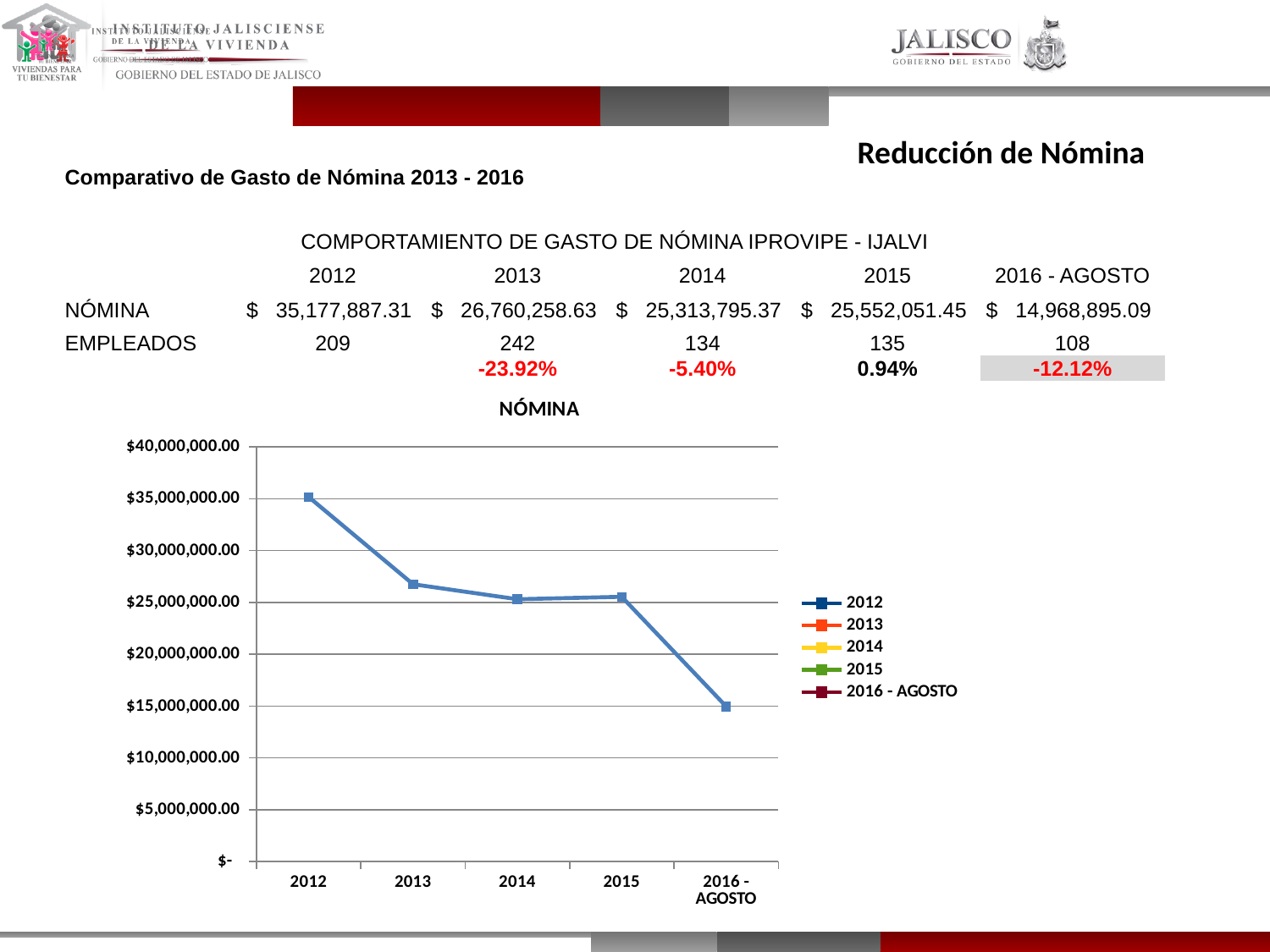
How many entries does the legend of the NÓMINA chart list? 5 What is the difference between the nómina values for 2012 and 2013? $ 8,417,628.68 Which year has the highest nómina value on the chart? 2012 What is the nómina value for 2012? $ 35,177,887.31 Do the nómina values generally rise or fall from 2012 to 2016 - AGOSTO? fall Which period has the lowest nómina value on the chart? 2016 - AGOSTO What is the nómina value for 2016 - AGOSTO? $ 14,968,895.09 Which is larger, the nómina value for 2012 or for 2013? 2012 How many data points are plotted on the NÓMINA line chart? 5 What kind of chart is the NÓMINA chart? line chart Is the nómina value for 2013 greater or less than $25,000,000.00? greater Is the nómina value for 2016 - AGOSTO greater or less than $20,000,000.00? less